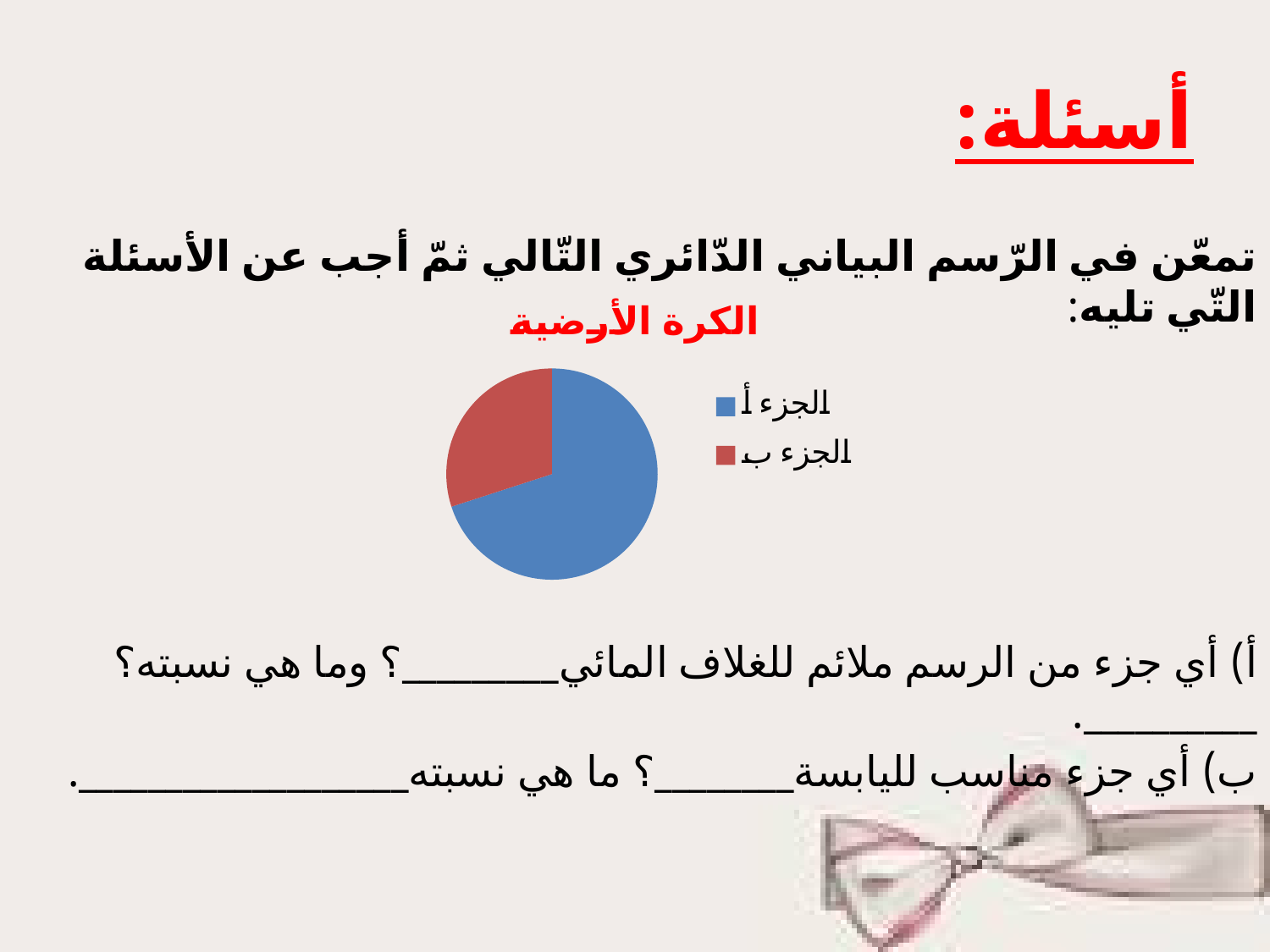
Which slice of the pie chart is the largest? الجزء أ How many entries does the legend of the pie chart list? 2 What colour is the slice for الجزء ب in the pie chart? red What kind of chart is shown on the slide? pie chart How many slices does the pie chart have? 2 What is the title of the pie chart? الكرة الأرضية Which is larger in the pie chart, الجزء أ or الجزء ب? الجزء أ Which slice of the pie chart is the smallest? الجزء ب